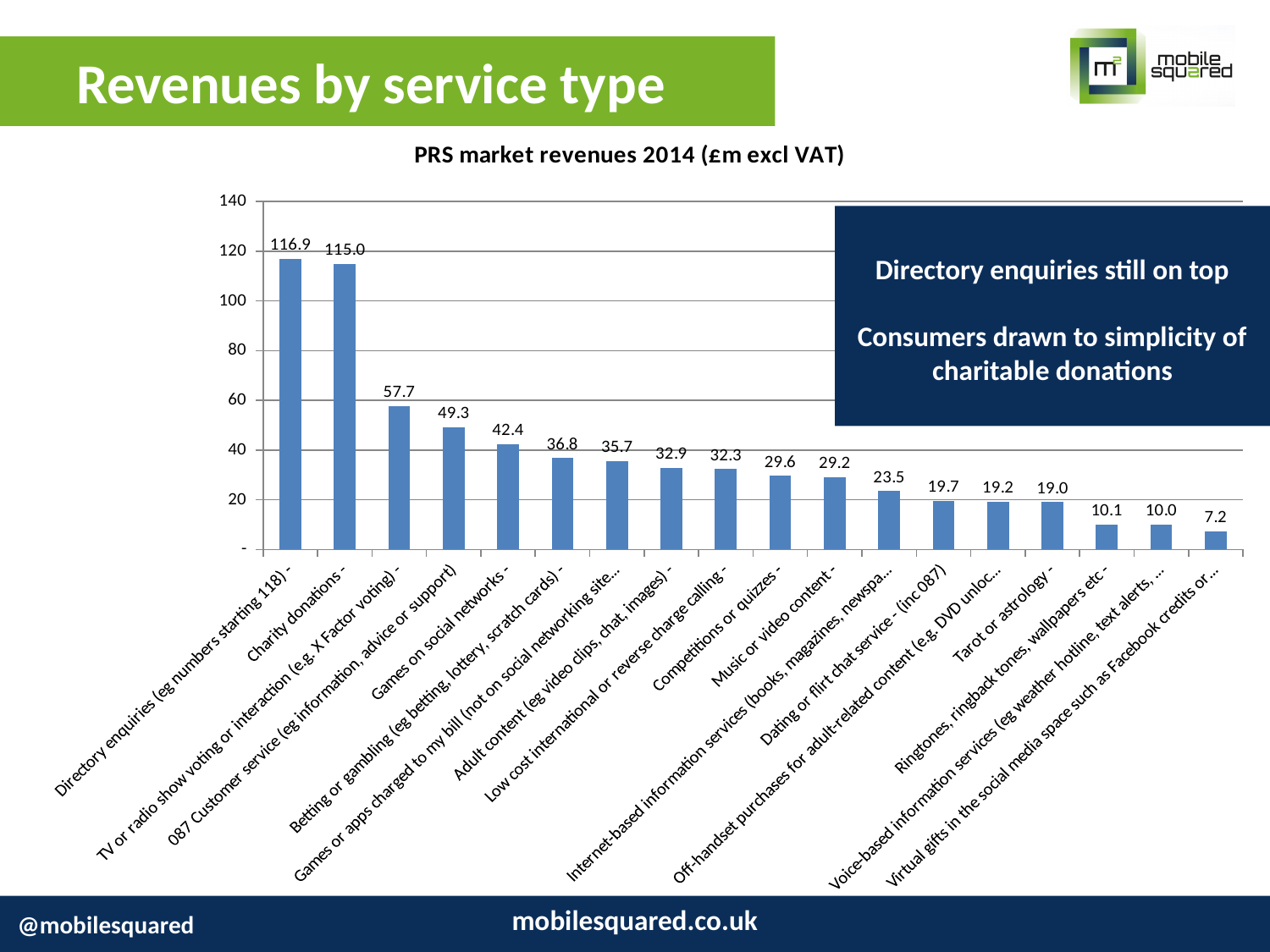
What is the difference between the values for Directory enquiries and Charity donations? 1.9 What kind of chart is shown on the slide? bar chart What is the value for Tarot or astrology? 19.0 What is the value for Games on social networks? 42.4 Which service type has the lowest revenue? Virtual gifts in the social media space such as Facebook credits How many service types are shown in the chart? 18 What is the value for Charity donations? 115.0 What is the value for Competitions or quizzes? 29.6 Which service type has the highest revenue? Directory enquiries (eg numbers starting 118) Which is larger, the value for Betting or gambling or the value for Adult content? Betting or gambling What is the title of the chart? PRS market revenues 2014 (£m excl VAT) Is the value for TV or radio show voting or interaction greater or less than 60? less